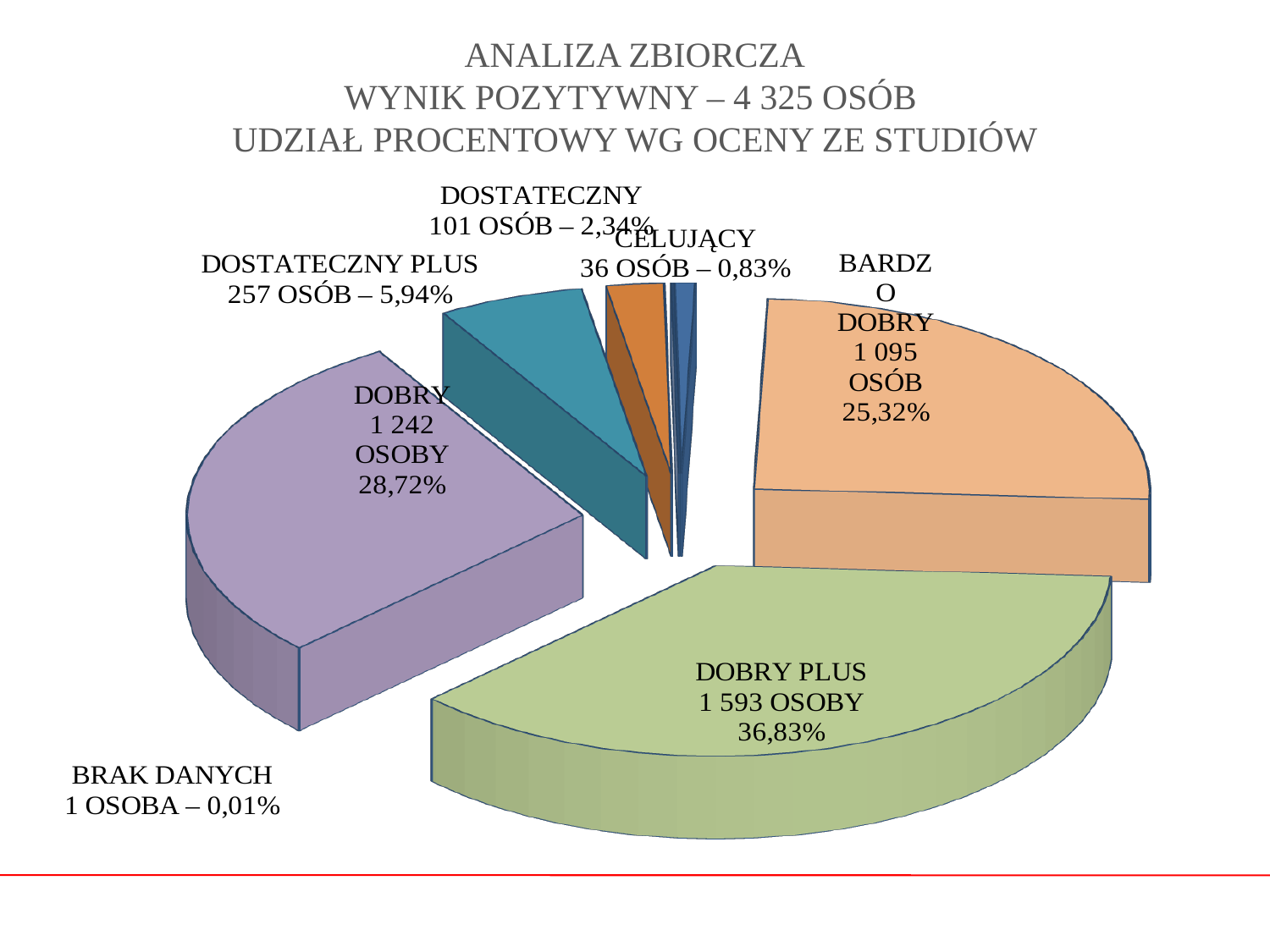
What kind of chart is shown on the slide? pie chart Which category has the smallest share of the pie? BRAK DANYCH How many people are in the BARDZO DOBRY category? 1 095 Which category has more people, DOBRY or BARDZO DOBRY? DOBRY What is the difference in the number of people between DOBRY PLUS and DOBRY? 351 Which category has the largest share of the pie? DOBRY PLUS How many categories does the pie chart show? 7 What percentage share does the DOBRY PLUS slice have? 36,83% What percentage share does the DOBRY slice have? 28,72% According to the chart title, how many people had a positive result (WYNIK POZYTYWNY)? 4 325 How many people are in the DOSTATECZNY PLUS category? 257 What percentage share does the CELUJĄCY slice have? 0,83%